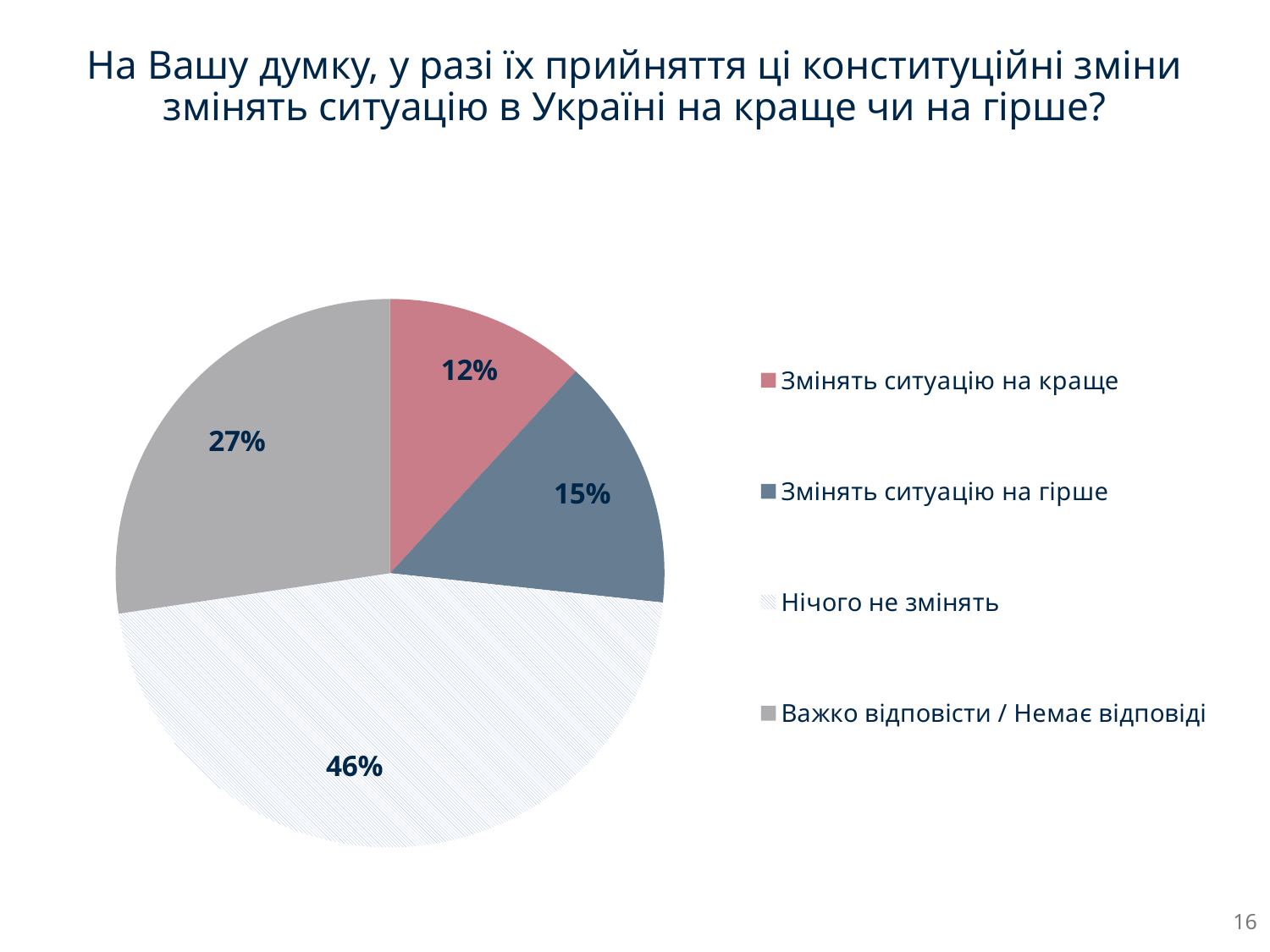
Which response has the smallest slice of the pie? Змінять ситуацію на краще What share of respondents said the changes would change the situation for the better (Змінять ситуацію на краще)? 12% Which is larger: the share for 'Змінять ситуацію на гірше' or for 'Змінять ситуацію на краще'? Змінять ситуацію на гірше What share of respondents said the changes would change the situation for the worse (Змінять ситуацію на гірше)? 15% What share of respondents said nothing would change (Нічого не змінять)? 46% How many slices does the pie chart have? 4 How many entries does the legend list? 4 Which response has the largest slice of the pie? Нічого не змінять What is the difference in percentage points between 'Нічого не змінять' and 'Важко відповісти / Немає відповіді'? 19 What share of respondents found it hard to answer or gave no answer (Важко відповісти / Немає відповіді)? 27% What colour is the slice for 'Змінять ситуацію на краще'? pink/red What kind of chart is shown on the slide? pie chart